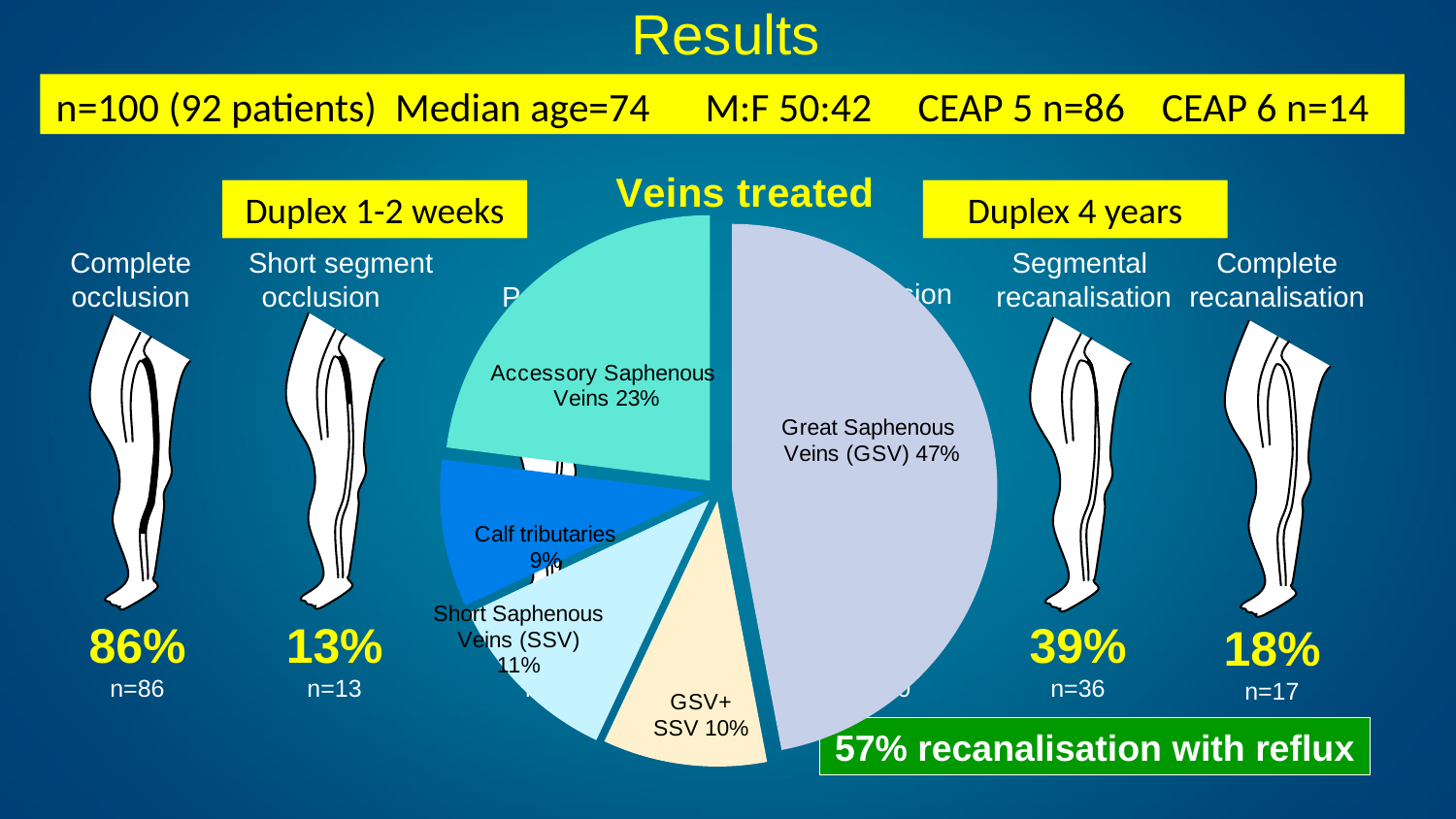
What percentage of the "Veins treated" pie is Accessory Saphenous Veins? 23% What percentage of the "Veins treated" pie is Short Saphenous Veins (SSV)? 11% What share of the "Veins treated" pie is Great Saphenous Veins (GSV)? 47% How many slices does the "Veins treated" pie chart have? 5 In the "Veins treated" pie, what is the difference in percentage points between Great Saphenous Veins (GSV) and Accessory Saphenous Veins? 24 In the "Veins treated" pie, which is larger: Short Saphenous Veins (SSV) or Calf tributaries? Short Saphenous Veins (SSV) What percentage of the "Veins treated" pie is GSV+SSV? 10% Which slice of the "Veins treated" pie is the smallest? Calf tributaries What kind of chart is the "Veins treated" chart? pie chart What percentage of the "Veins treated" pie is Calf tributaries? 9% What is the title of the pie chart? Veins treated Which slice of the "Veins treated" pie is the largest? Great Saphenous Veins (GSV)